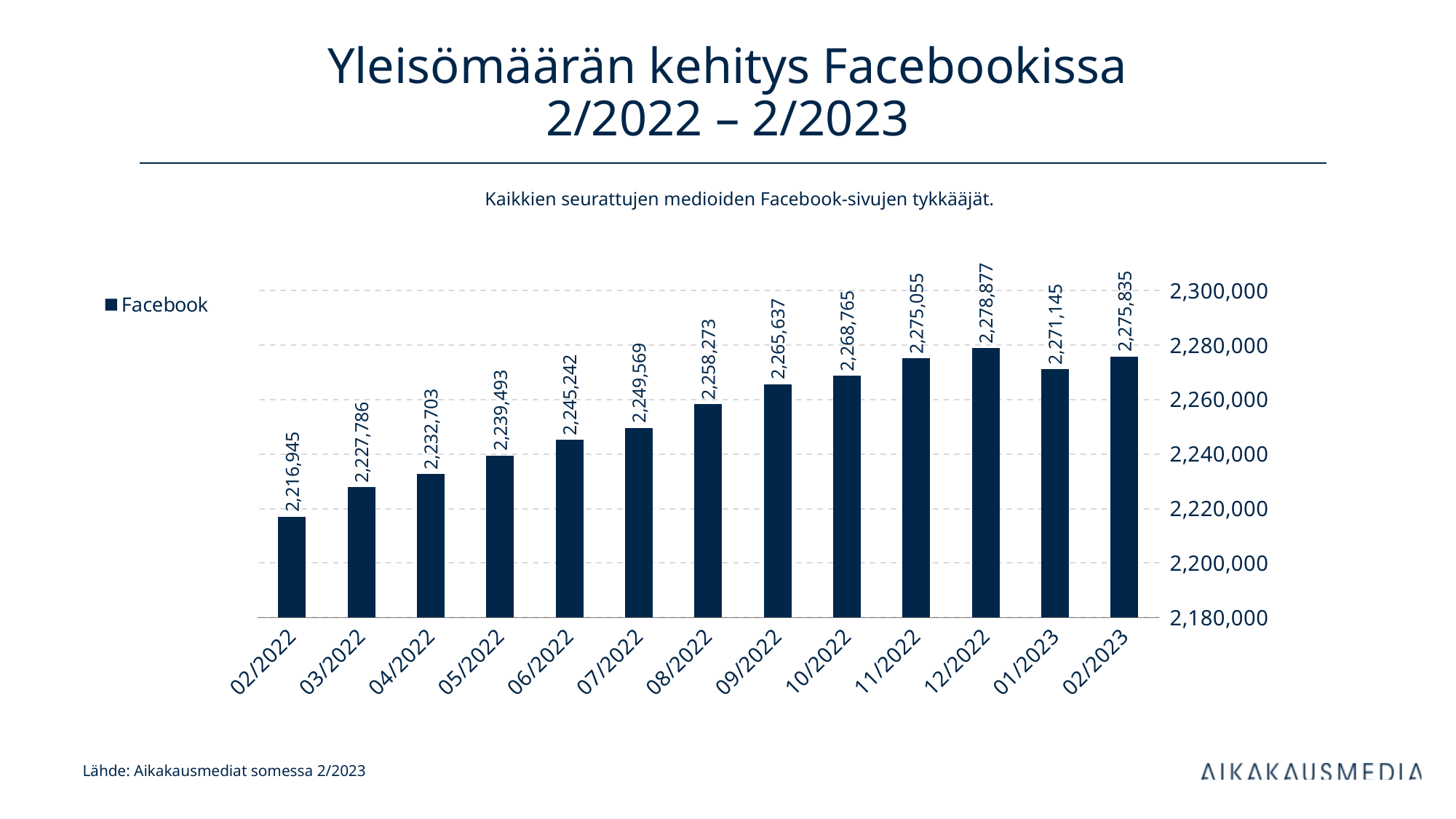
What is the difference between the values for 02/2023 and 02/2022? 58,890 What is the value for 02/2022? 2,216,945 Is the value for 06/2022 greater or less than 2,240,000? greater Which month has the highest value? 12/2022 What kind of chart is shown on the slide? bar chart Which is larger, the value for 08/2022 or the value for 10/2022? 10/2022 What is the value for 09/2022? 2,265,637 How many series does the legend list? 1 What is the value for 01/2023? 2,271,145 What is the difference between the values for 12/2022 and 01/2023? 7,732 How many months are shown on the x axis? 13 Which month has the lowest value? 02/2022